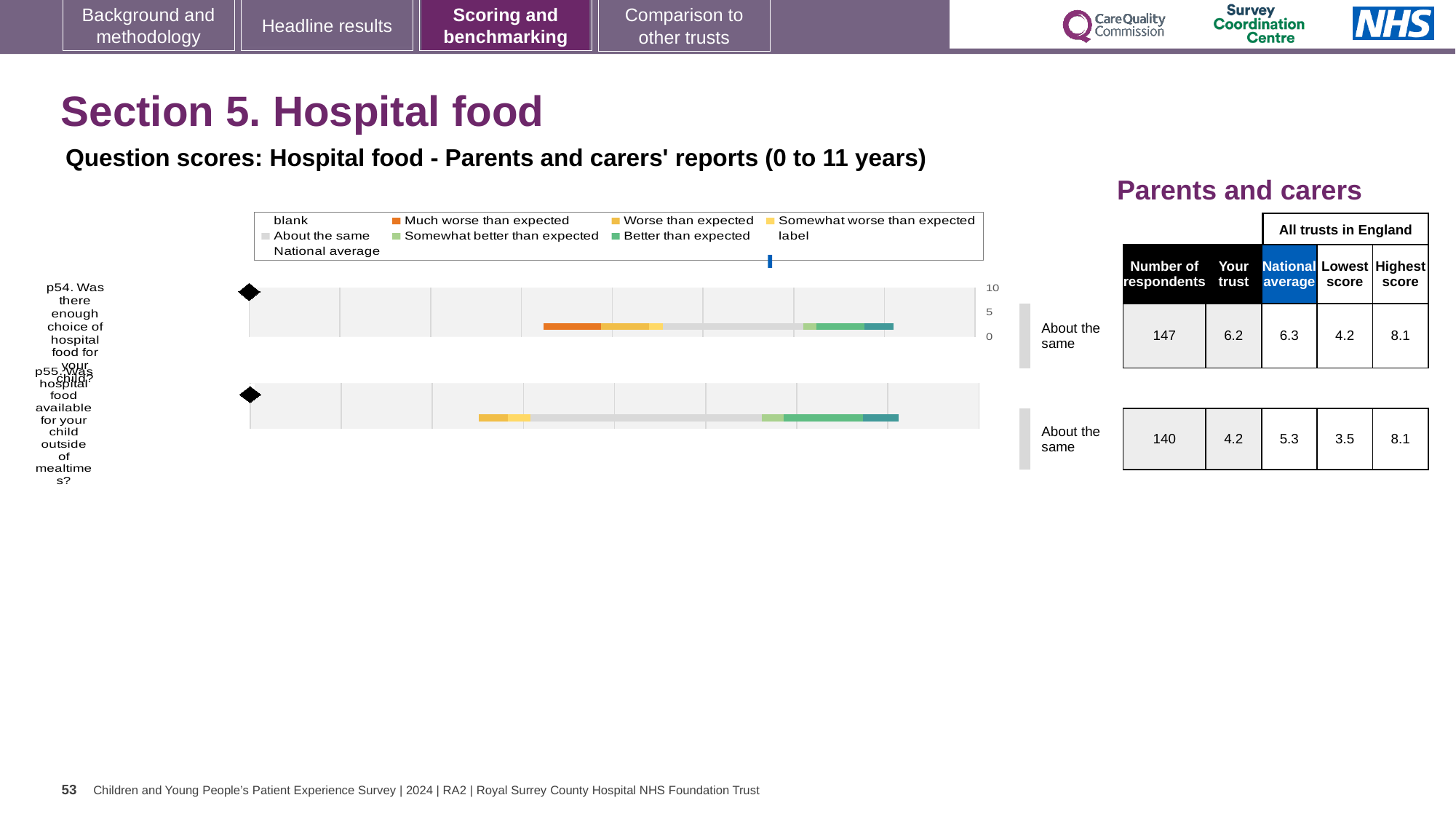
Which legend entry is shown as a light grey band in the chart? About the same According to the table next to the chart, what is the national average for p55? 5.3 Which colour in the chart legend represents 'Much worse than expected'? orange According to the table next to the chart, how many respondents answered p55 (hospital food available outside of mealtimes)? 140 What kind of chart is shown on the slide? bar chart What benchmark category is shown for p54 next to the chart? About the same Is the 'Your trust' score for p55 greater or less than 5? less What is the difference between the highest score and the lowest score for p54 in the table? 3.9 According to the table next to the chart, what is the 'Your trust' score for p54 (enough choice of hospital food)? 6.2 Which question has more respondents, p54 or p55? p54 How many questions (categories) are plotted in the chart? 2 Which question has the higher 'Your trust' score, p54 or p55? p54